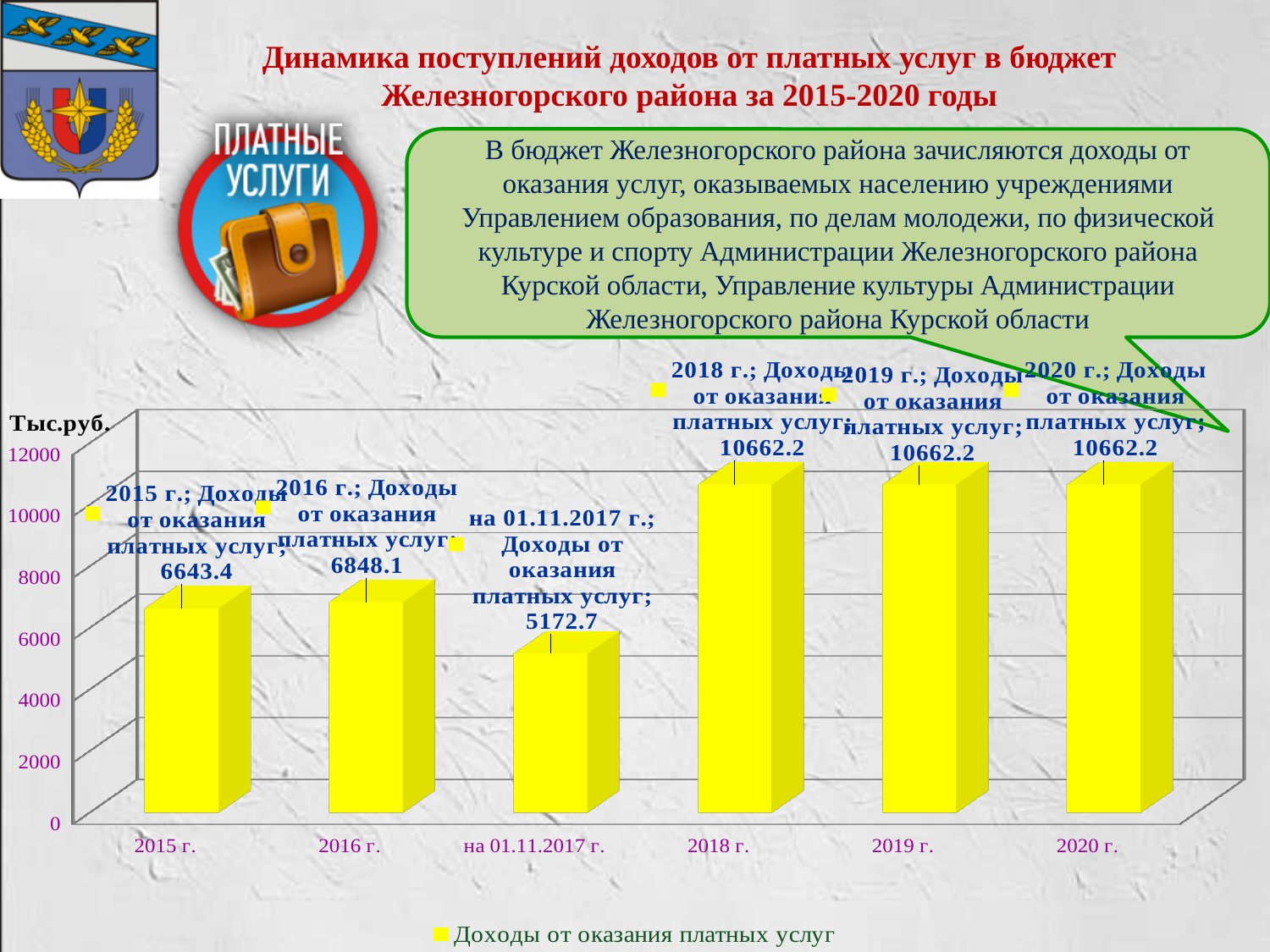
What is the value for 2015 г.? 6643.4 Which is larger, the value for 2015 г. or the value for 2016 г.? 2016 г. What is the difference between the values for 2016 г. and 2015 г.? 204.7 Is the value for 2019 г. greater or less than 10000? greater What kind of chart is shown on the slide? bar chart How many categories are shown on the x axis? 6 What is the value for на 01.11.2017 г.? 5172.7 How many series does the legend list? 1 What is the value for 2020 г.? 10662.2 What is the difference between the values for 2018 г. and на 01.11.2017 г.? 5489.5 What is the value for 2016 г.? 6848.1 Which category has the lowest value? на 01.11.2017 г.